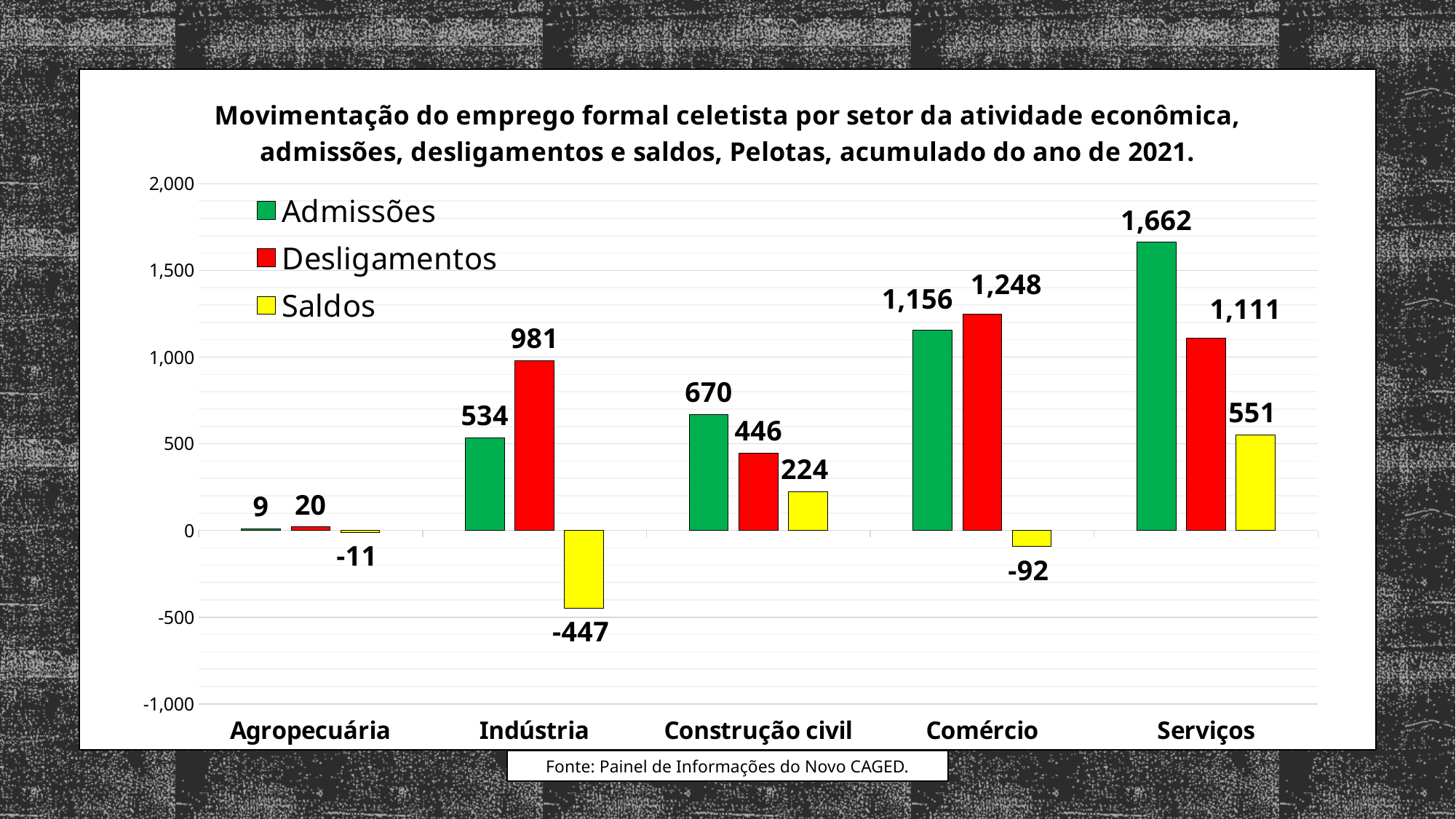
What colour represents the Saldos series? Yellow Is the Desligamentos value for Serviços greater or less than 1,000? greater How many sectors are shown on the x axis? 5 What is the Desligamentos value for Indústria? 981 What is the Saldos value for Comércio? -92 Which sector has the highest Admissões value? Serviços How many series does the legend list? 3 Which is larger for Construção civil, Admissões or Desligamentos? Admissões What is the Admissões value for Serviços? 1,662 What is the difference between Desligamentos and Admissões for Comércio? 92 What kind of chart is shown on the slide? Bar chart Which sector has the lowest Saldos value? Indústria